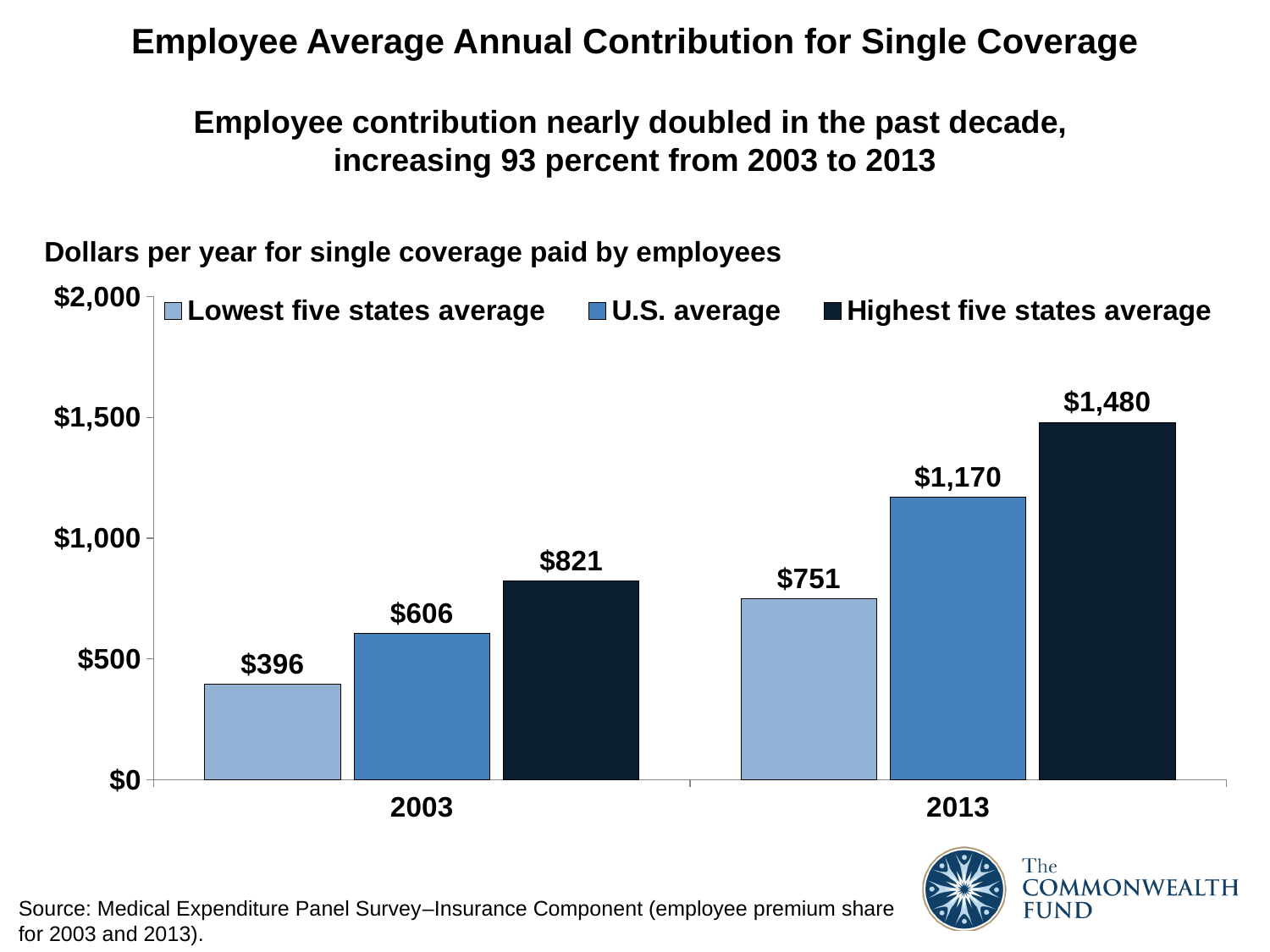
Which is larger: the lowest five states average in 2013 or the U.S. average in 2003? Lowest five states average in 2013 Is the highest five states average in 2003 greater or less than $1,000? less What was the highest five states average employee contribution in 2013? $1,480 Which series has the highest value in 2013? Highest five states average What was the lowest five states average employee contribution in 2013? $751 Does the U.S. average rise or fall from 2003 to 2013? Rise What is the difference between the U.S. average in 2013 and the U.S. average in 2003? $564 What kind of chart is shown on the slide? Bar chart How many series does the legend list? 3 Which series has the lowest value in 2003? Lowest five states average What was the U.S. average employee contribution for single coverage in 2003? $606 What is the difference between the highest five states average and the lowest five states average in 2003? $425